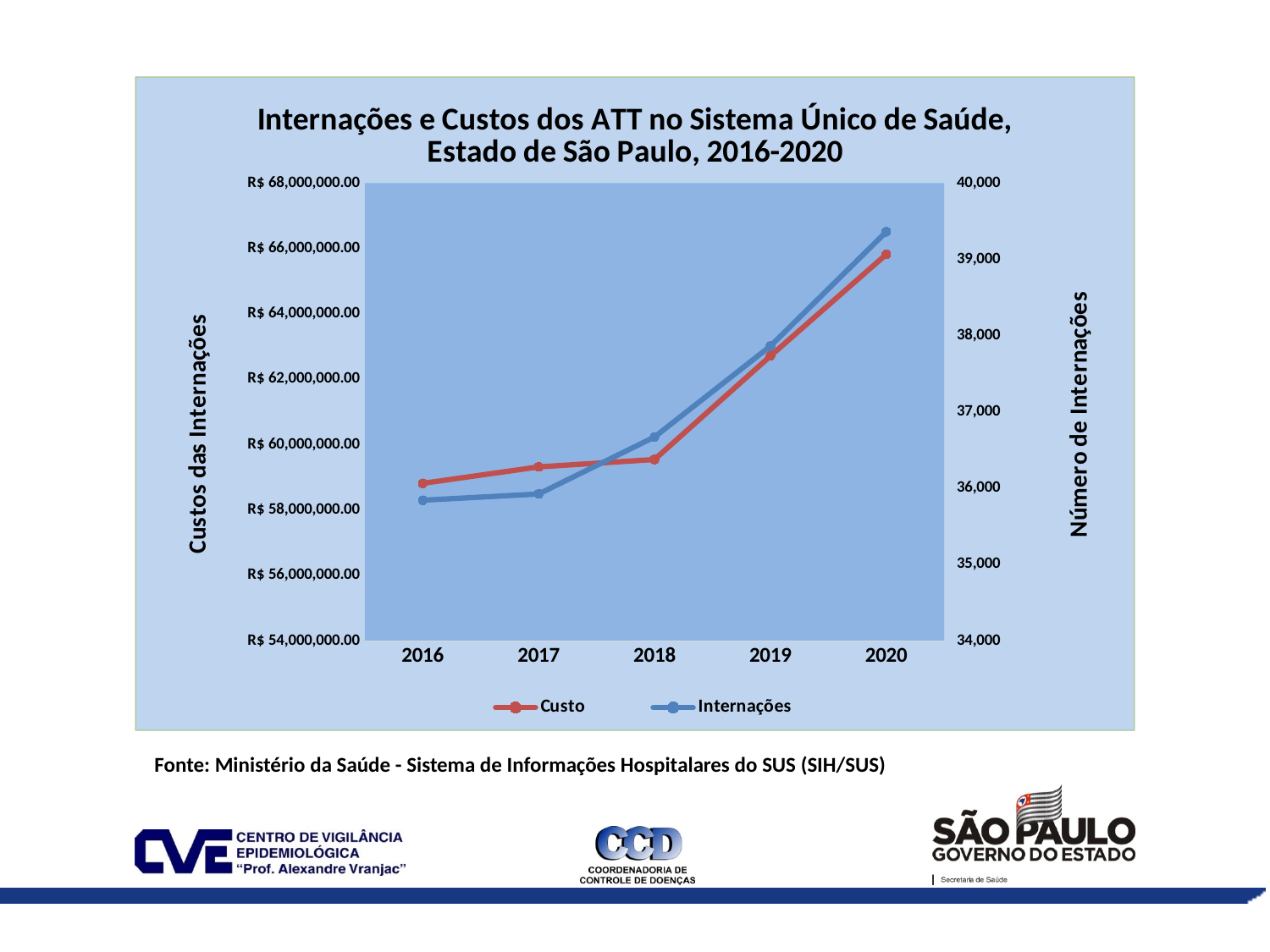
Is the Custo value for 2016 greater or less than R$ 60,000,000.00? less Is the Internações value for 2016 greater or less than 37,000? less Is the Custo value for 2020 greater or less than R$ 64,000,000.00? greater What kind of chart is shown on the slide? Line chart What is the label of the right-hand vertical axis? Número de Internações In which year is the Custo series at its highest? 2020 How many series does the legend list? 2 Do the Internações values rise or fall from 2016 to 2020? Rise How many years are plotted along the x axis? 5 In which year is the Internações series at its highest? 2020 In which year is the Custo series at its lowest? 2016